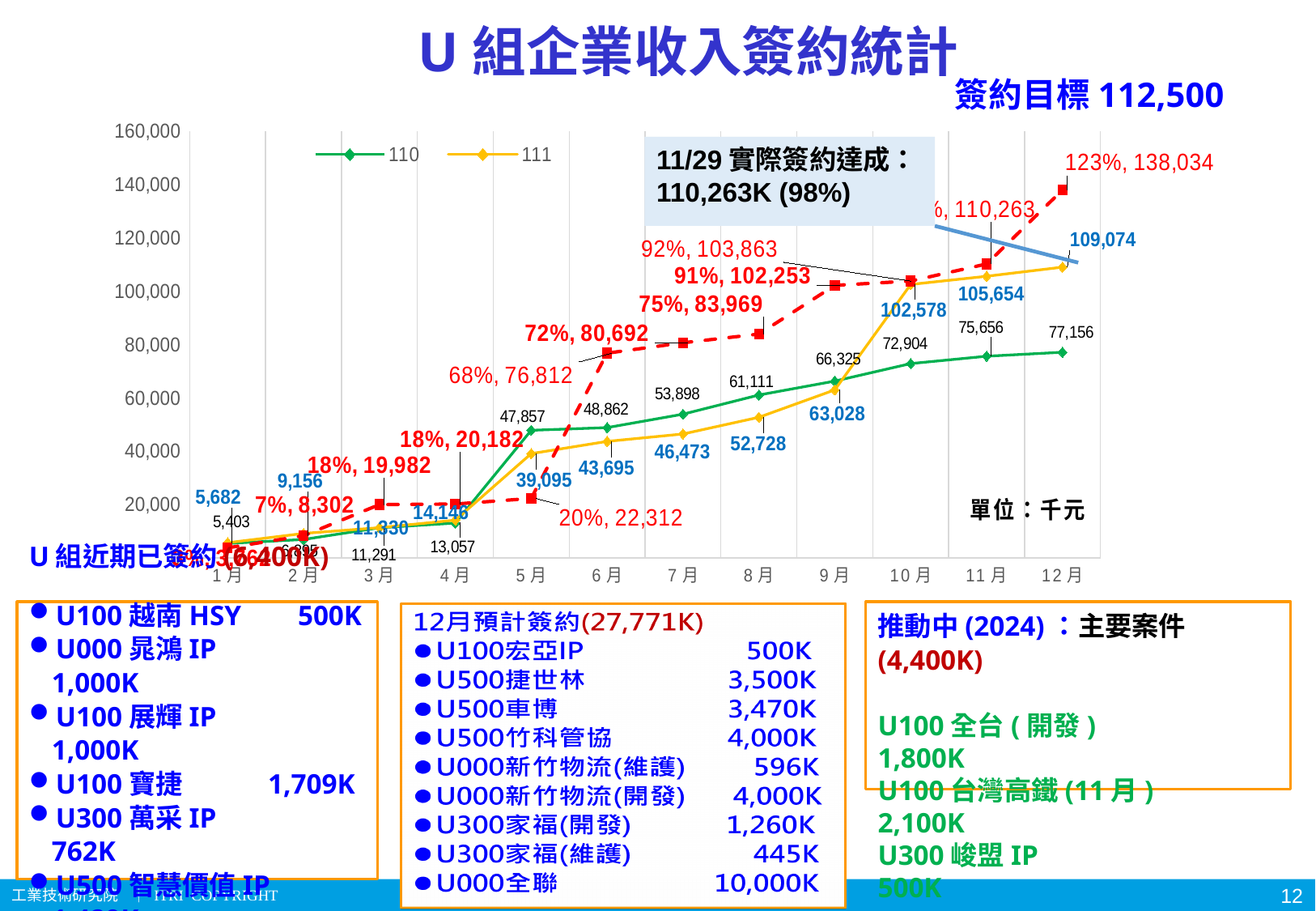
What is the value of series 111 in 12月? 109,074 What is the value of series 110 in 12月? 77,156 What is the value of series 110 in 5月? 47,857 How many months are plotted on the x axis? 12 Which series has the larger value in 8月, 110 or 111? 110 Does series 111 generally rise or fall from 1月 to 12月? rise What is the difference between series 111 and series 110 in 12月? 31,918 How many series does the chart legend list? 2 In which month is series 110 at its lowest value? 1月 What type of chart is shown on the slide? line chart What is the value of series 111 in 10月? 102,578 In which month does series 111 reach its highest value? 12月